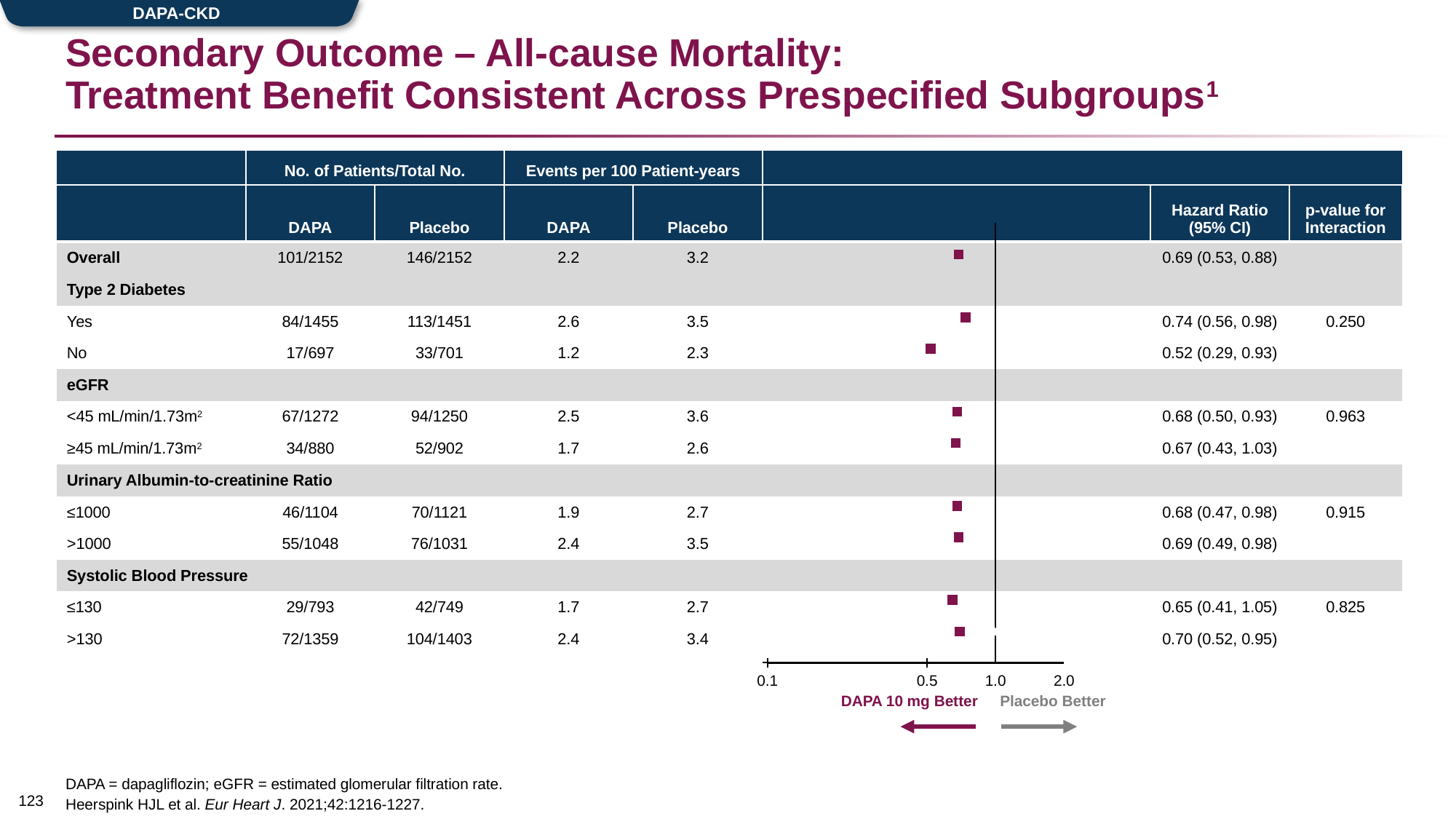
Which subgroup has the highest hazard ratio point estimate in the forest plot? Type 2 Diabetes: Yes Which subgroup has the lowest hazard ratio point estimate in the forest plot? Type 2 Diabetes: No What is the difference between the hazard ratio point estimates for Type 2 Diabetes Yes and Type 2 Diabetes No? 0.22 Which has the larger hazard ratio point estimate: Type 2 Diabetes Yes or systolic blood pressure ≤130? Type 2 Diabetes Yes What kind of chart is shown on the slide? Forest plot How many hazard ratio points are plotted in the forest plot? 9 What is the hazard ratio for patients with eGFR <45 mL/min/1.73m²? 0.68 (0.50, 0.93) Is the hazard ratio point estimate for the Overall group greater or less than 1.0? less What is the hazard ratio for patients with systolic blood pressure >130? 0.70 (0.52, 0.95) What is the p-value for interaction for the eGFR subgroup? 0.963 What is the hazard ratio for patients with Type 2 Diabetes (Yes)? 0.74 (0.56, 0.98) What is the hazard ratio for the Overall group in the forest plot? 0.69 (0.53, 0.88)